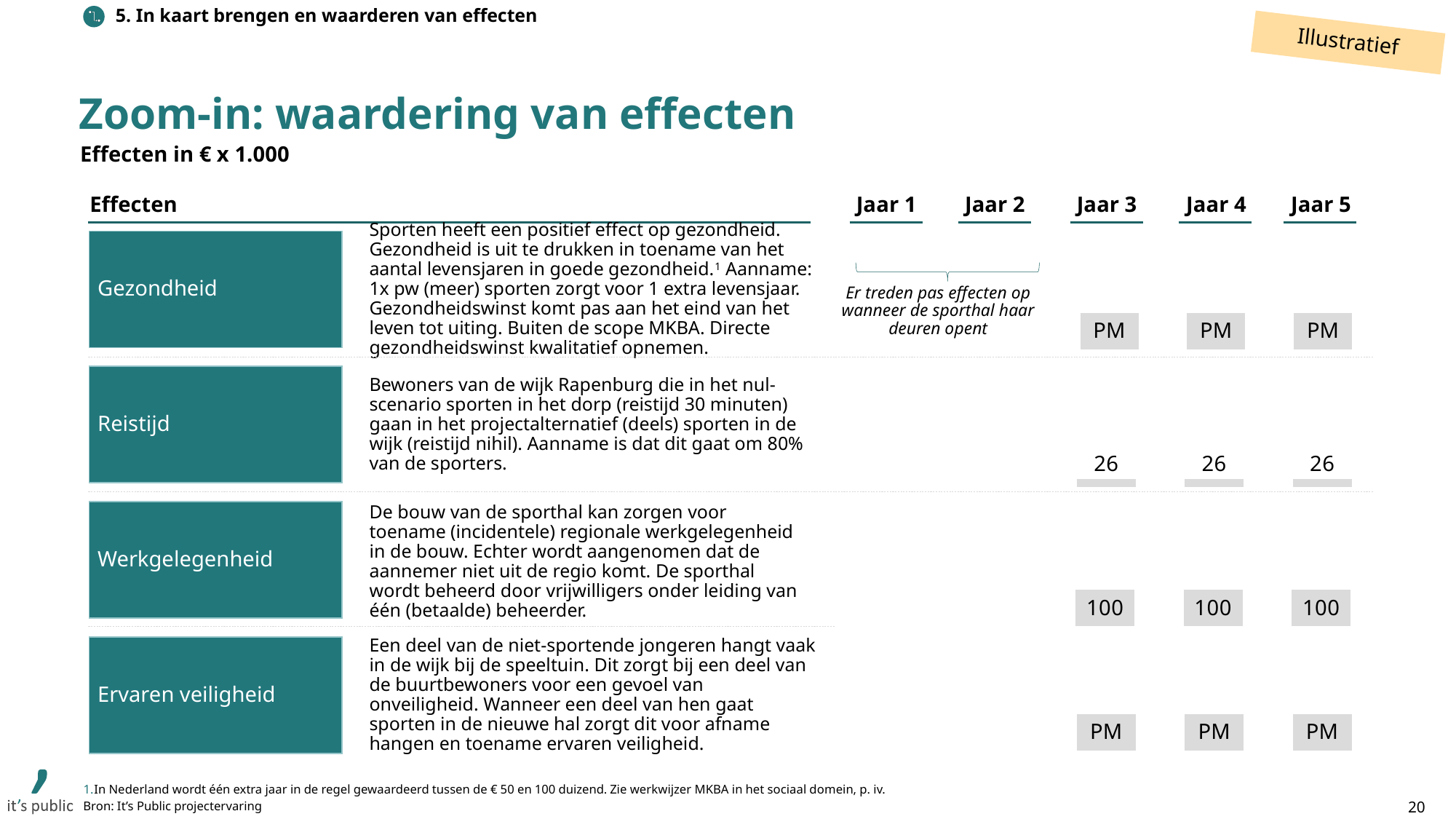
Which is larger in Jaar 4, the value for Reistijd or the value for Werkgelegenheid? Werkgelegenheid What is the value for Werkgelegenheid in Jaar 5? 100 How many year columns (Jaar) are shown? 5 What is the value for Reistijd in Jaar 5? 26 Does the value for Reistijd change between Jaar 3 and Jaar 5? No, it stays at 26 In which unit are the effects expressed, according to the subtitle? € x 1.000 What is shown for Gezondheid in Jaar 4? PM What is the value for Reistijd in Jaar 3? 26 According to the note above the Jaar 1 and Jaar 2 columns, why are no values shown there? Er treden pas effecten op wanneer de sporthal haar deuren opent How many effects (rows) are listed in the table? 4 What is shown for Ervaren veiligheid in Jaar 3? PM What is the difference between the Werkgelegenheid value and the Reistijd value in Jaar 3? 74